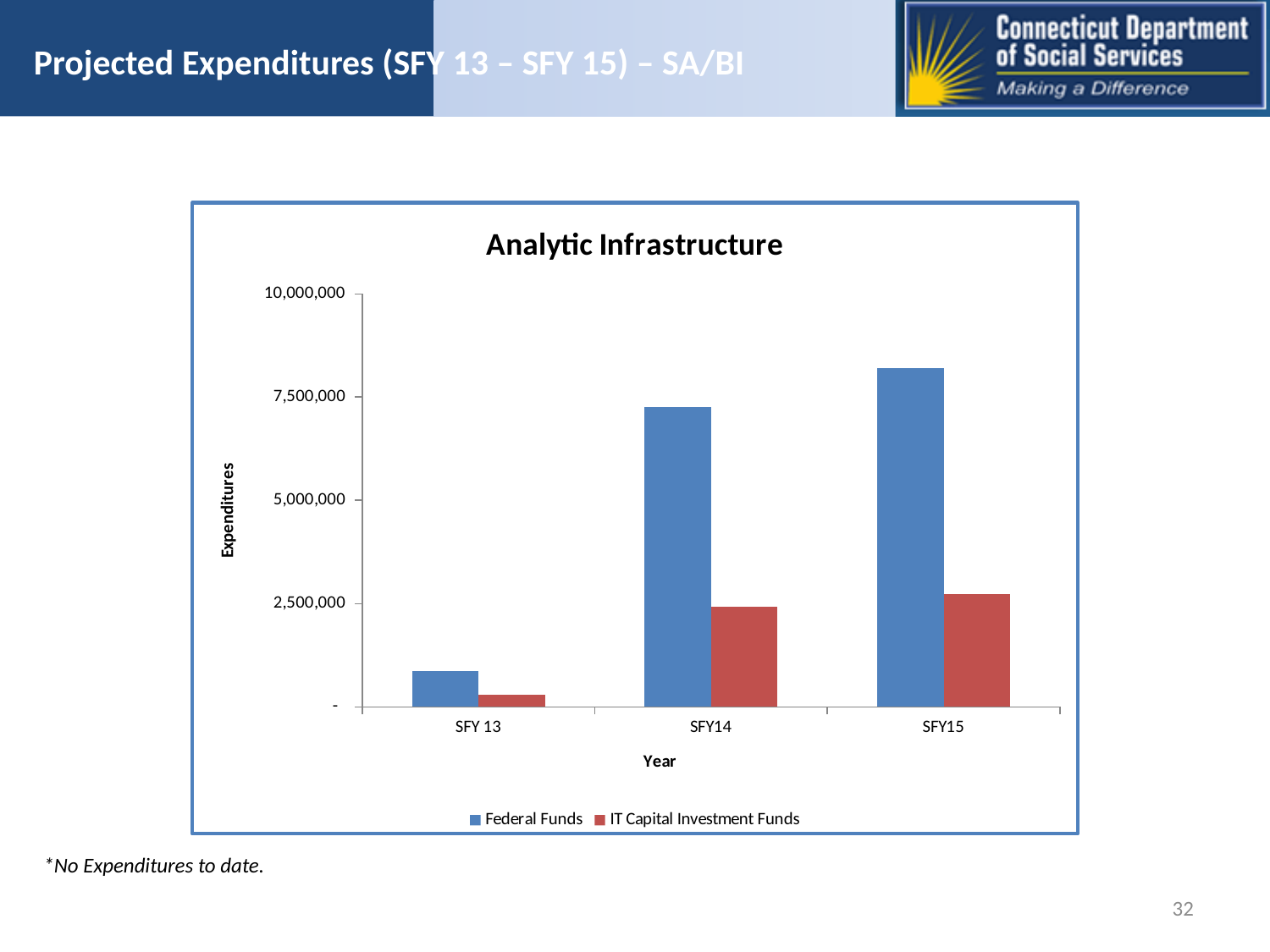
How many series does the chart's legend list? 2 What is the title of the chart? Analytic Infrastructure Is the Federal Funds value for SFY 13 greater or less than 2,500,000? less Is the IT Capital Investment Funds value for SFY14 greater or less than 5,000,000? less In which year is the Federal Funds value highest? SFY15 Do the Federal Funds values rise or fall from SFY 13 to SFY15? Rise Is the Federal Funds value for SFY15 greater or less than 7,500,000? greater In which year is the IT Capital Investment Funds value lowest? SFY 13 How many years are shown on the x axis of the chart? 3 In SFY14, which is larger: Federal Funds or IT Capital Investment Funds? Federal Funds What type of chart is shown on the slide? Bar chart